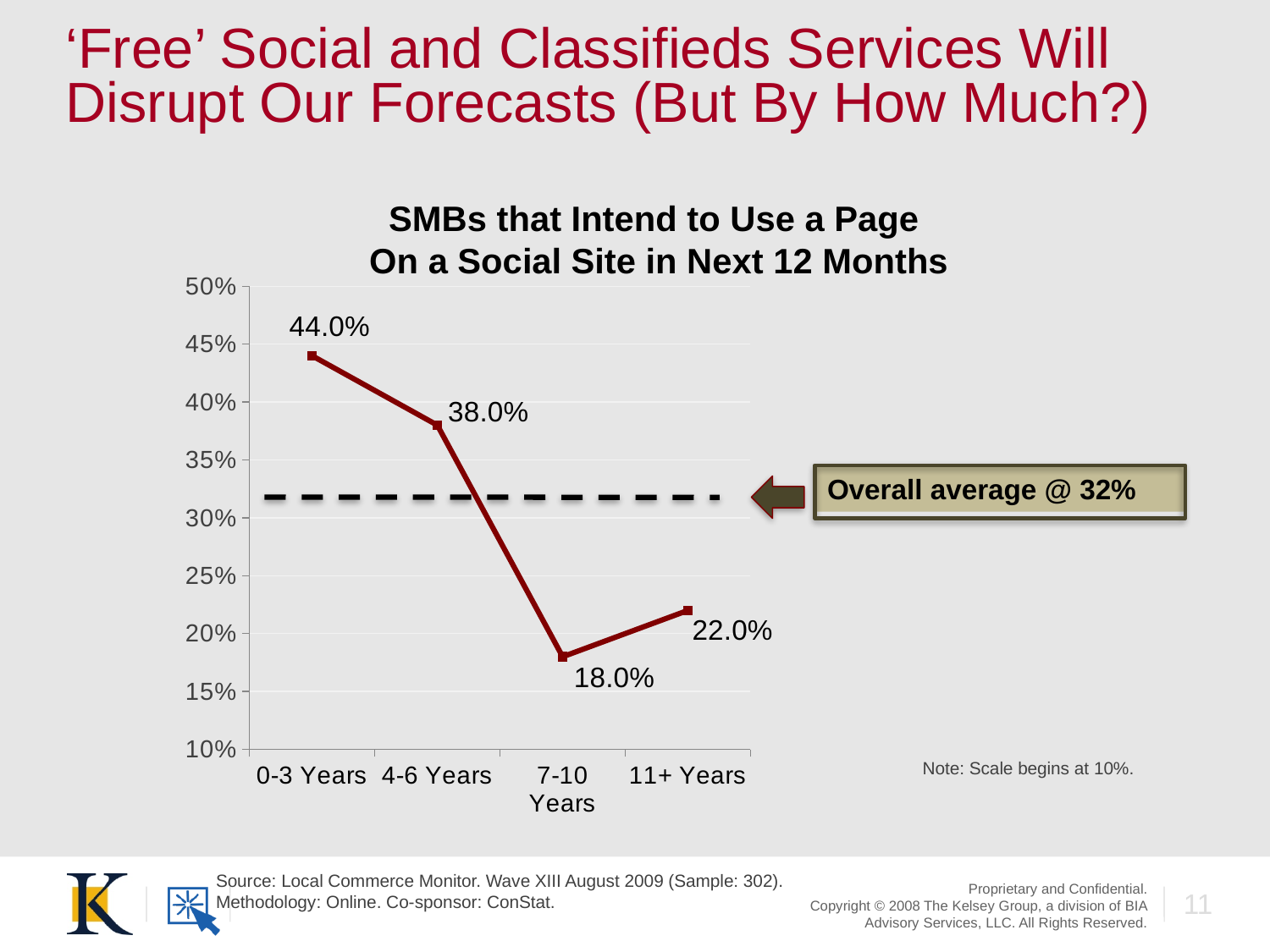
What overall average does the dashed line on the chart represent? 32% What kind of chart is shown on the slide? Line chart How many age categories are plotted on the chart? 4 What is the value for the 11+ Years category? 22.0% What is the difference between the values for 11+ Years and 7-10 Years? 4.0% Which category has the highest value? 0-3 Years What is the value for the 7-10 Years category? 18.0% What percentage of SMBs in the 0-3 Years category intend to use a page on a social site in the next 12 months? 44.0% Do the values rise or fall from 0-3 Years to 7-10 Years? Fall What is the difference between the values for 0-3 Years and 4-6 Years? 6.0% Which is larger, the value for 4-6 Years or the value for 11+ Years? 4-6 Years Which category has the lowest value? 7-10 Years